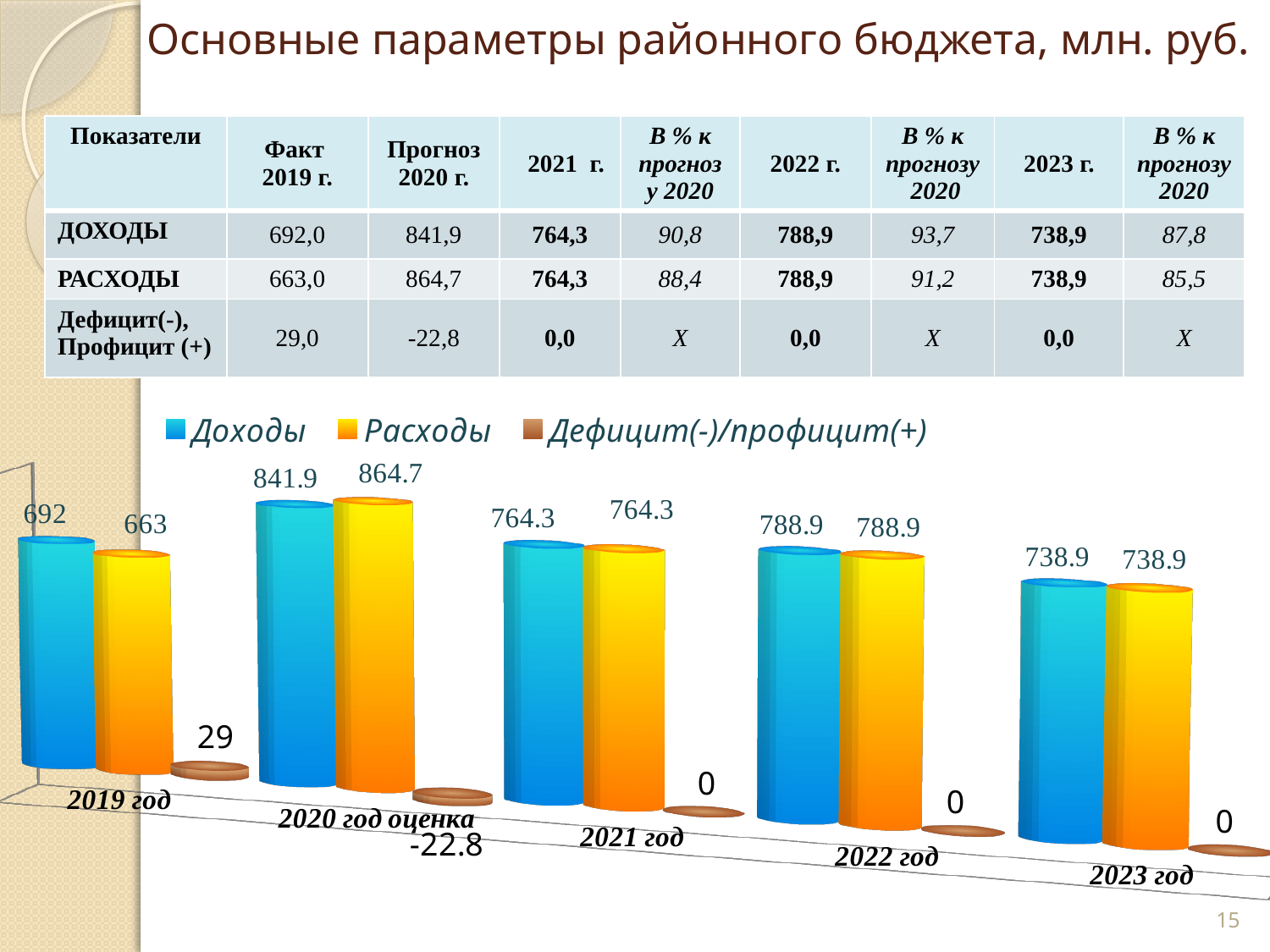
Which year has the lowest Расходы value in the chart? 2019 год What type of chart is shown on the slide? Bar chart What is the value of Доходы for 2019 год in the chart? 692 What is the value of Доходы for 2023 год in the chart? 738.9 In the chart, which is larger for 2019 год: Доходы or Расходы? Доходы What is the difference between Расходы and Доходы for 2020 год оценка in the chart? 22.8 What is the value of Дефицит(-)/профицит(+) for 2020 год оценка in the chart? -22.8 Does the Доходы value rise or fall from 2022 год to 2023 год in the chart? Fall What is the value of Расходы for 2020 год оценка in the chart? 864.7 Which year has the highest Доходы value in the chart? 2020 год оценка How many year categories are shown on the chart's x axis? 5 How many series does the chart legend list? 3